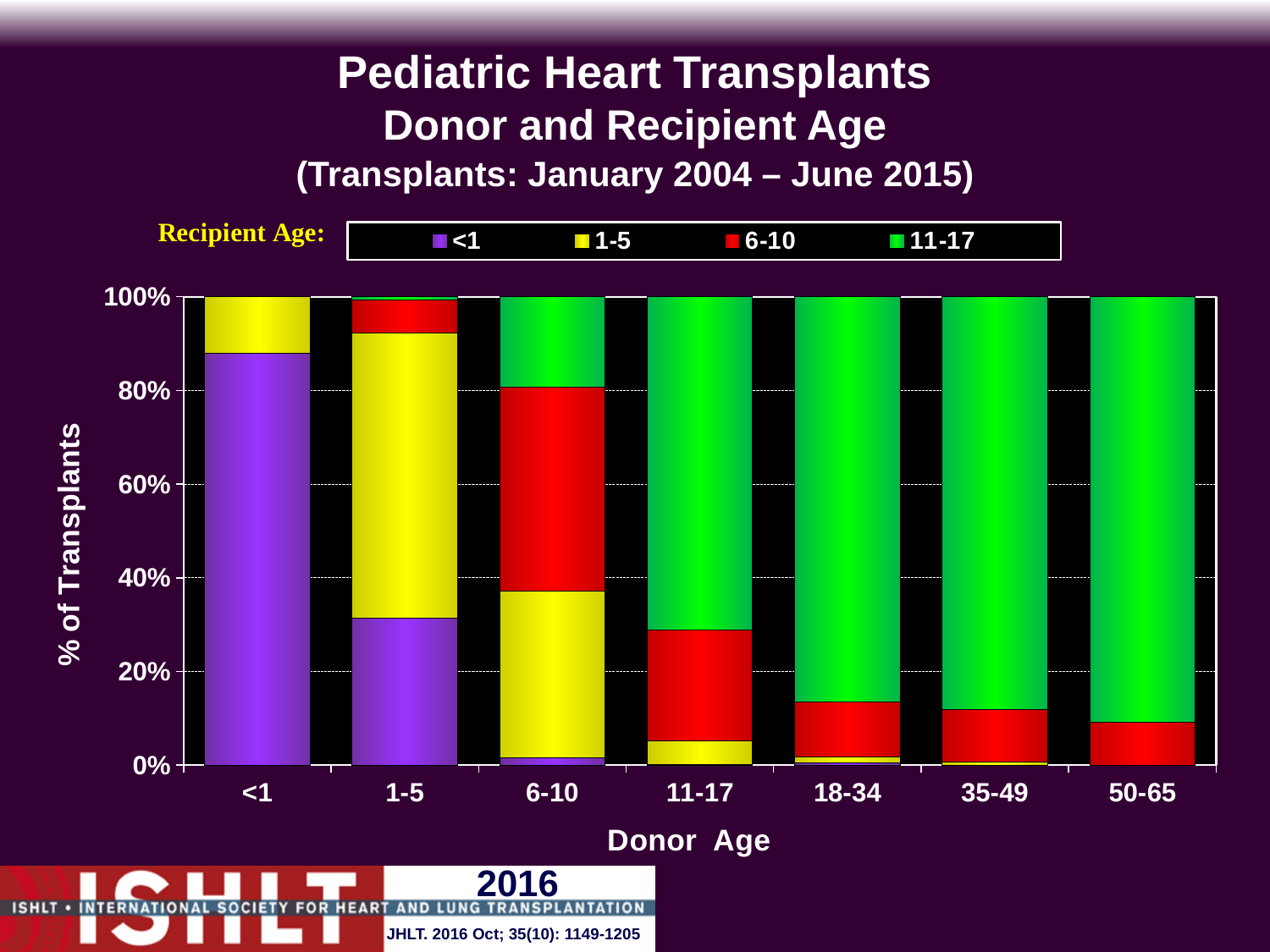
Which donor age group has the largest share of recipients aged 1-5? 1-5 What is the title of the x axis? Donor Age Is the share of recipients aged 11-17 for donor age 18-34 greater or less than 80%? greater Is the share of recipients aged <1 for donor age <1 greater or less than 80%? greater How many donor age categories are shown on the x axis? 7 Which donor age group has a larger share of recipients aged <1: <1 or 1-5? <1 Is the share of recipients aged 6-10 for donor age 50-65 greater or less than 20%? less Which donor age group has the largest share of recipients aged <1? <1 Does the share of recipients aged 11-17 rise or fall as donor age increases from <1 to 50-65? rise What kind of chart is shown on the slide? Stacked bar chart How many recipient age series does the legend list? 4 Which donor age group has the largest share of recipients aged 6-10? 6-10